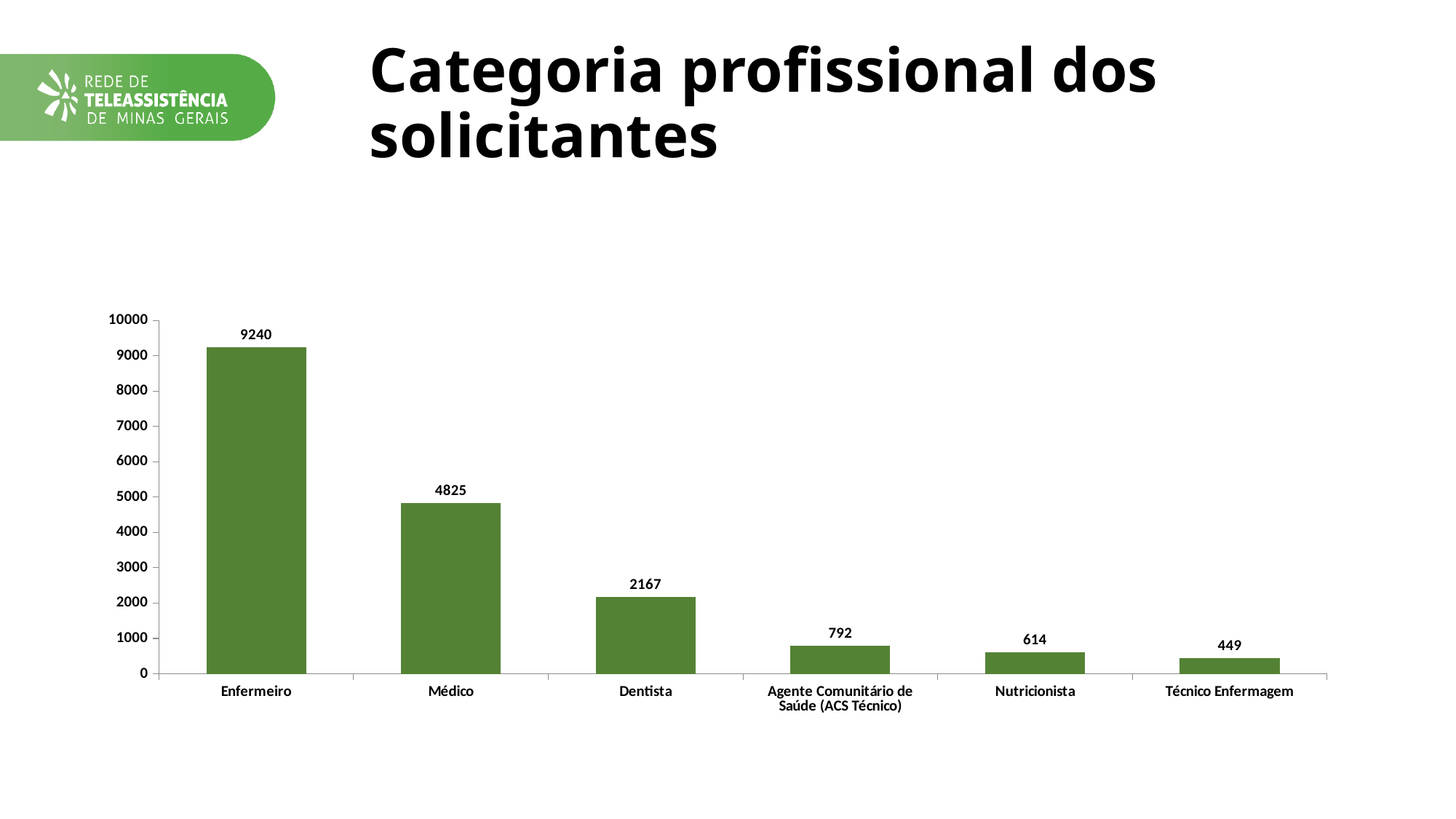
Which category has the lowest value? Técnico Enfermagem What is the value for Técnico Enfermagem? 449 Which category has the highest value? Enfermeiro How many categories are shown on the x axis? 6 What is the value for Dentista? 2167 What is the value for Enfermeiro? 9240 What is the value for Médico? 4825 What is the value for Agente Comunitário de Saúde (ACS Técnico)? 792 Which is larger, the value for Nutricionista or the value for Técnico Enfermagem? Nutricionista What is the difference between the values for Enfermeiro and Médico? 4415 What kind of chart is shown on the slide? Bar chart What is the title of the slide? Categoria profissional dos solicitantes